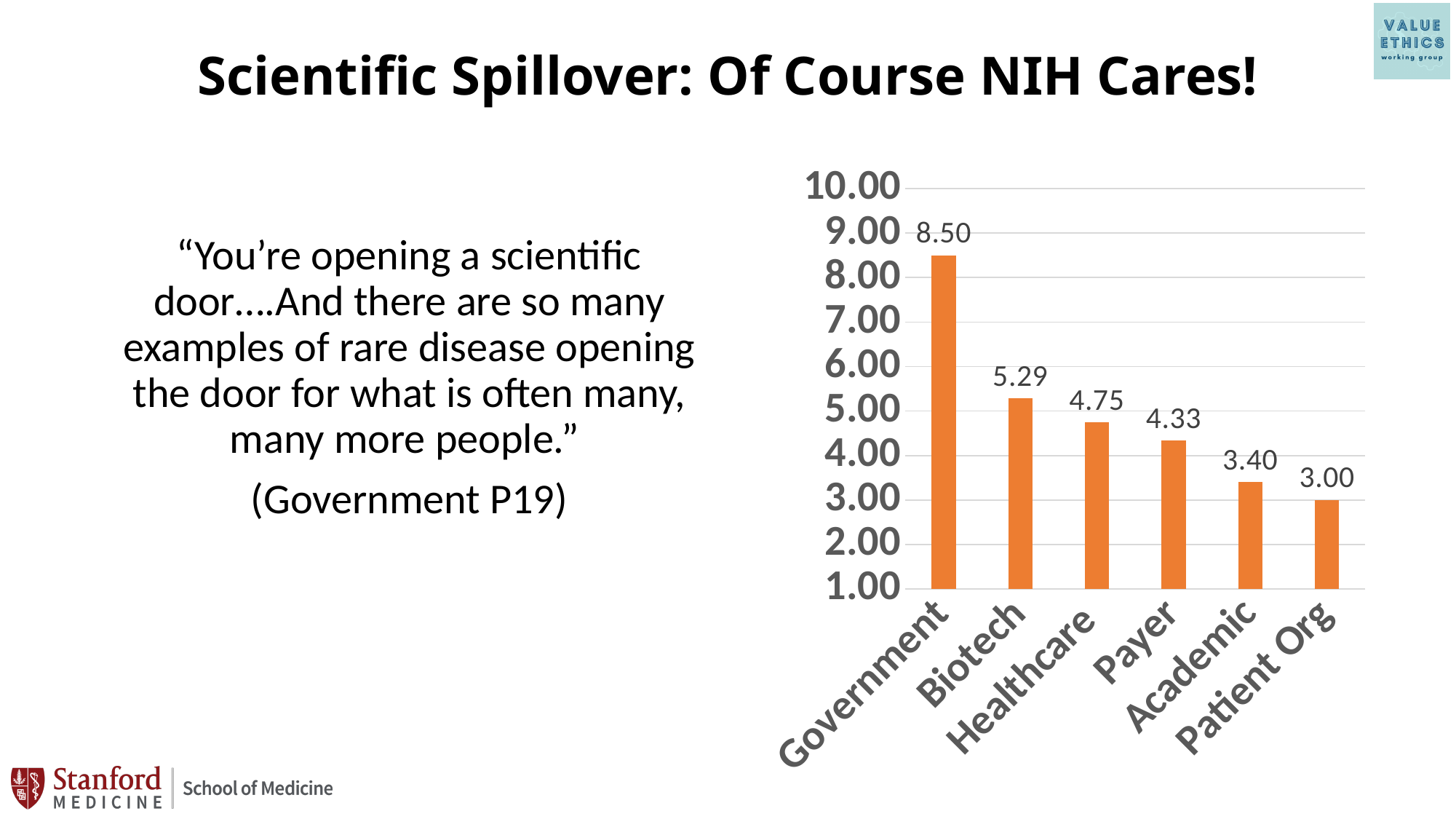
Which category has the lowest value? Patient Org Which is larger, the value for Academic or the value for Payer? Payer What is the value for Payer? 4.33 What is the value for Healthcare? 4.75 What kind of chart is shown on the slide? Bar chart Which category has the highest value? Government What is the value for Government? 8.50 How many categories are shown on the x axis? 6 Do the values rise or fall from left to right along the x axis? Fall What is the value for Patient Org? 3.00 What is the difference between the values for Government and Biotech? 3.21 What is the value for Biotech? 5.29